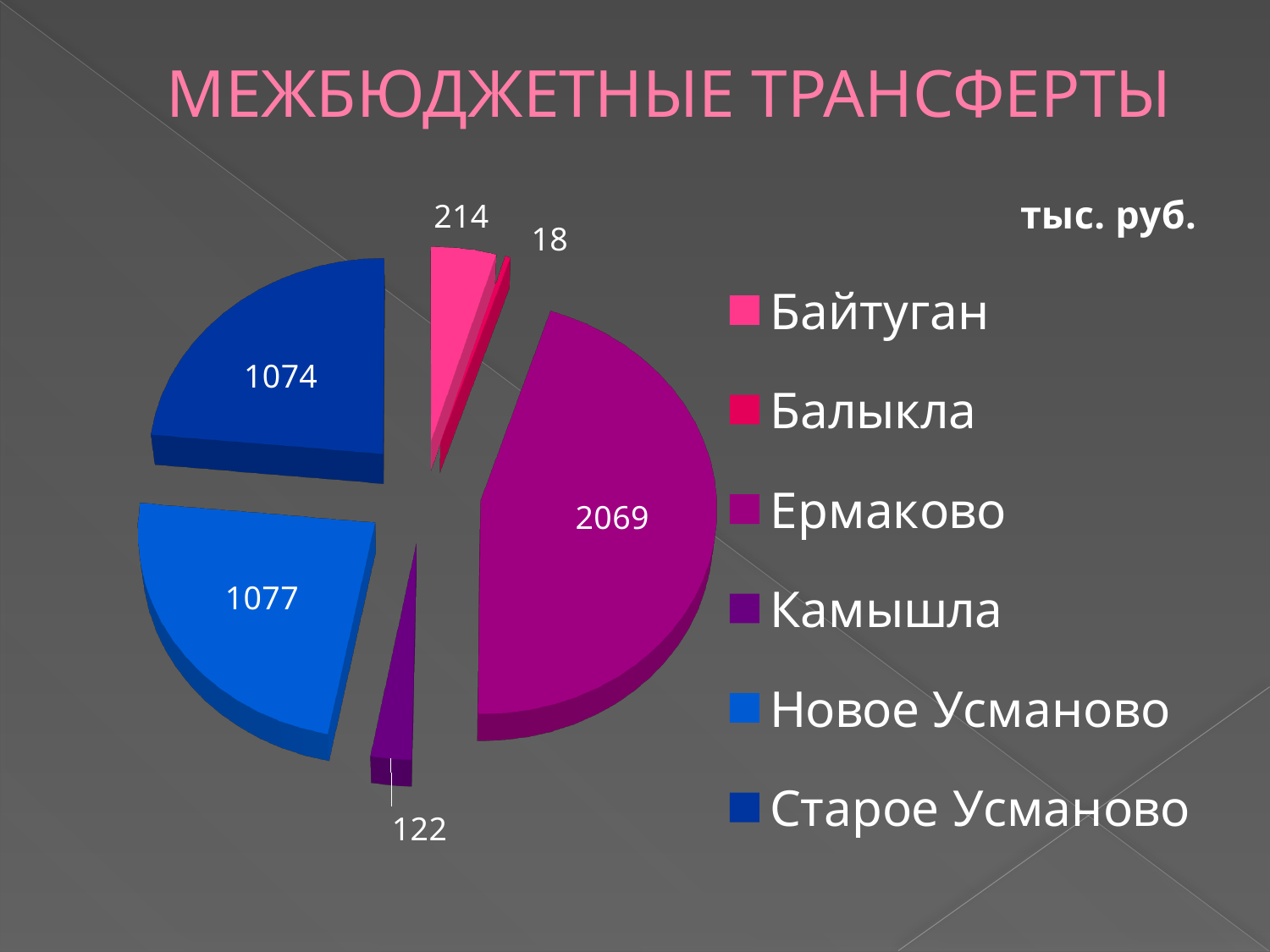
What kind of chart is shown on the slide? pie chart What is the value for Камышла? 122 What is the value for Байтуган? 214 Which is larger, the value for Новое Усманово or the value for Старое Усманово? Новое Усманово What is the difference between the values for Ермаково and Старое Усманово? 995 What is the value for Новое Усманово? 1077 Which category has the largest slice of the pie? Ермаково What unit is indicated for the values in the chart? тыс. руб. Which category has the smallest slice of the pie? Балыкла How many categories does the pie chart have? 6 What is the value for Ермаково? 2069